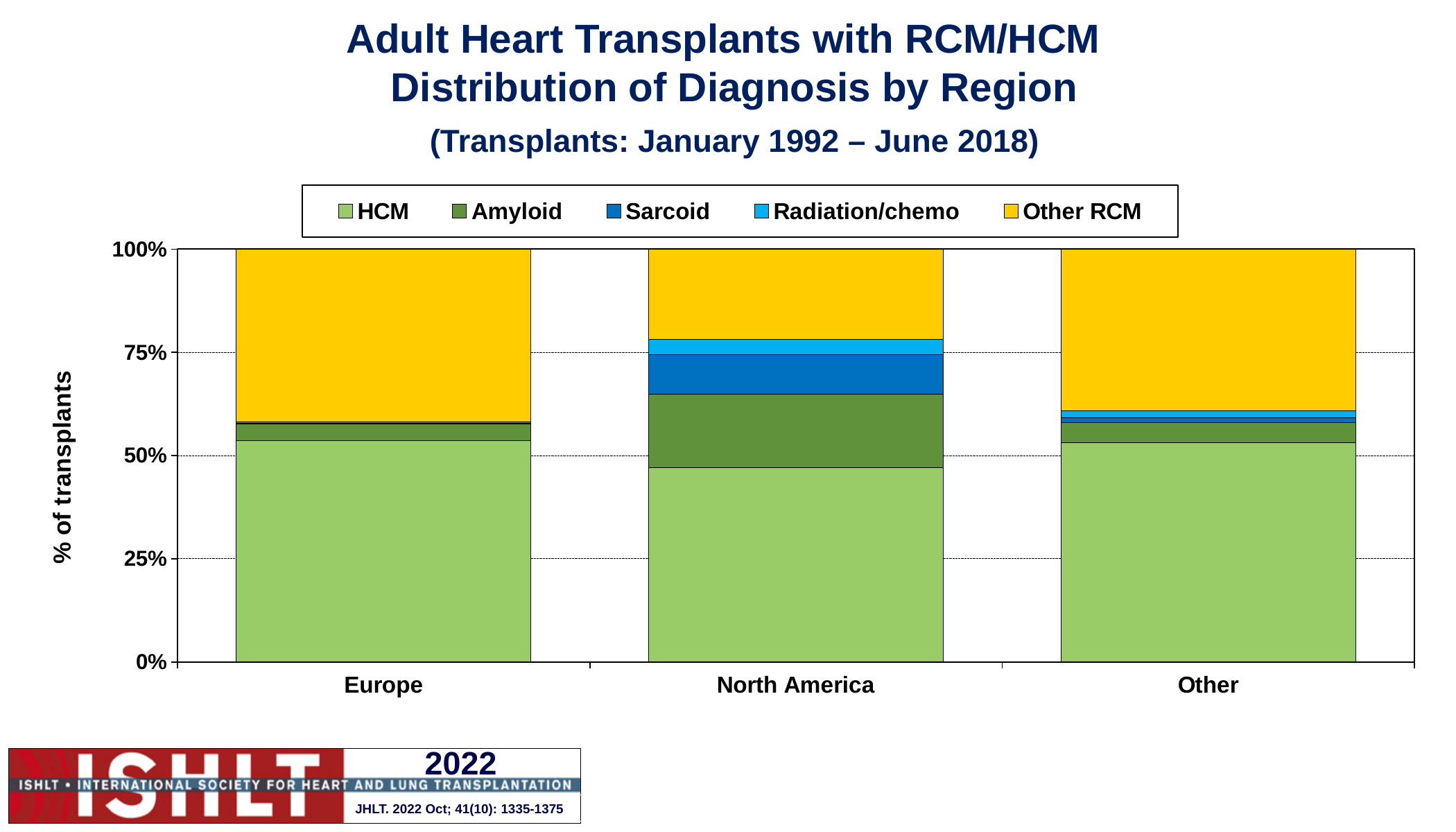
What transplant period does the chart title state? January 1992 – June 2018 What kind of chart is shown on the slide? Stacked bar chart What is the label of the y axis? % of transplants How many series does the legend list? 5 Is the Other RCM share larger in Europe or in North America? Europe Is the HCM share for North America greater or less than 50%? less Is the Other RCM share for Europe greater or less than 25%? greater Is the Sarcoid share larger in North America or in Europe? North America Is the HCM share for Europe greater or less than 50%? greater Which region has the largest Amyloid share? North America Which region has the smallest HCM share? North America How many regions are shown on the x axis of the chart? 3